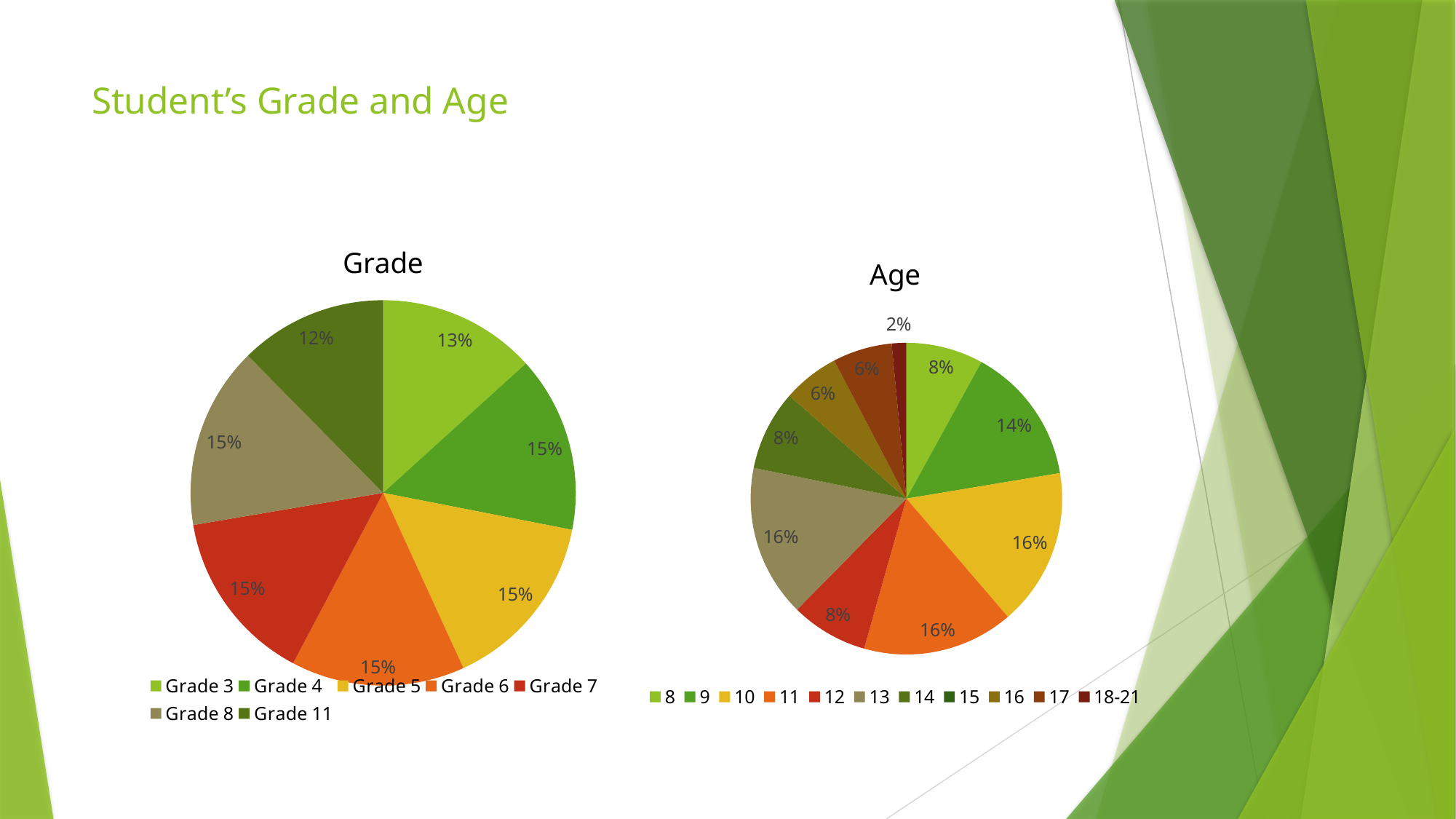
In the Age chart, what share of students are age 9? 14% How many grade categories does the Grade chart's legend list? 7 In the Age chart, what share of students are age 10? 16% In the Age chart, what share of students are age 12? 8% In the Grade chart, what is the difference between the Grade 3 share and the Grade 11 share? 1% In the Grade chart, what share of students are in Grade 3? 13% In the Grade chart, what share of students are in Grade 11? 12% In the Grade chart, which grade has the smallest share? Grade 11 In the Age chart, which is larger, the share for age 9 or the share for age 8? age 9 How many age categories does the Age chart's legend list? 11 In the Age chart, what is the smallest percentage shown on any slice? 2% What type of chart is the Grade chart? pie chart